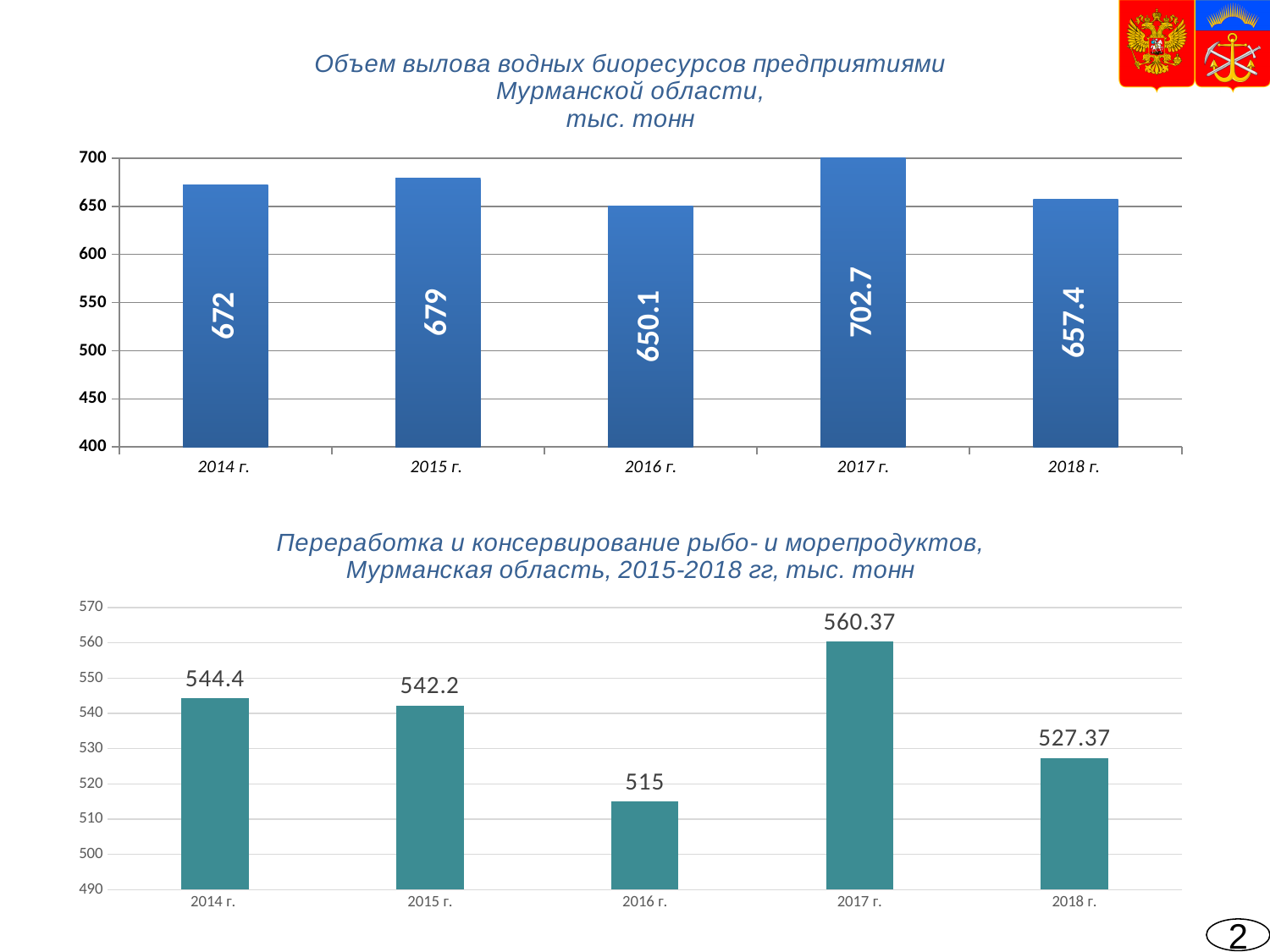
In the bottom chart (Переработка и консервирование рыбо- и морепродуктов), which is larger, the value for 2014 г. or 2015 г.? 2014 г. In the top chart (Объем вылова водных биоресурсов), what is the value for 2016 г.? 650.1 In the top chart (Объем вылова водных биоресурсов), what is the difference between the values for 2015 г. and 2014 г.? 7 In the top chart (Объем вылова водных биоресурсов), which year has the lowest value? 2016 г. In the bottom chart (Переработка и консервирование рыбо- и морепродуктов), what is the value for 2016 г.? 515 In the bottom chart (Переработка и консервирование рыбо- и морепродуктов), what is the difference between the values for 2017 г. and 2016 г.? 45.37 In the top chart (Объем вылова водных биоресурсов), what is the value for 2017 г.? 702.7 What kind of chart is the bottom chart (Переработка и консервирование рыбо- и морепродуктов)? Bar chart In the bottom chart (Переработка и консервирование рыбо- и морепродуктов), which year has the highest value? 2017 г. In the top chart (Объем вылова водных биоресурсов), which year has the highest value? 2017 г. In the bottom chart (Переработка и консервирование рыбо- и морепродуктов), what is the value for 2018 г.? 527.37 In the top chart (Объем вылова водных биоресурсов), how many years are shown on the x axis? 5